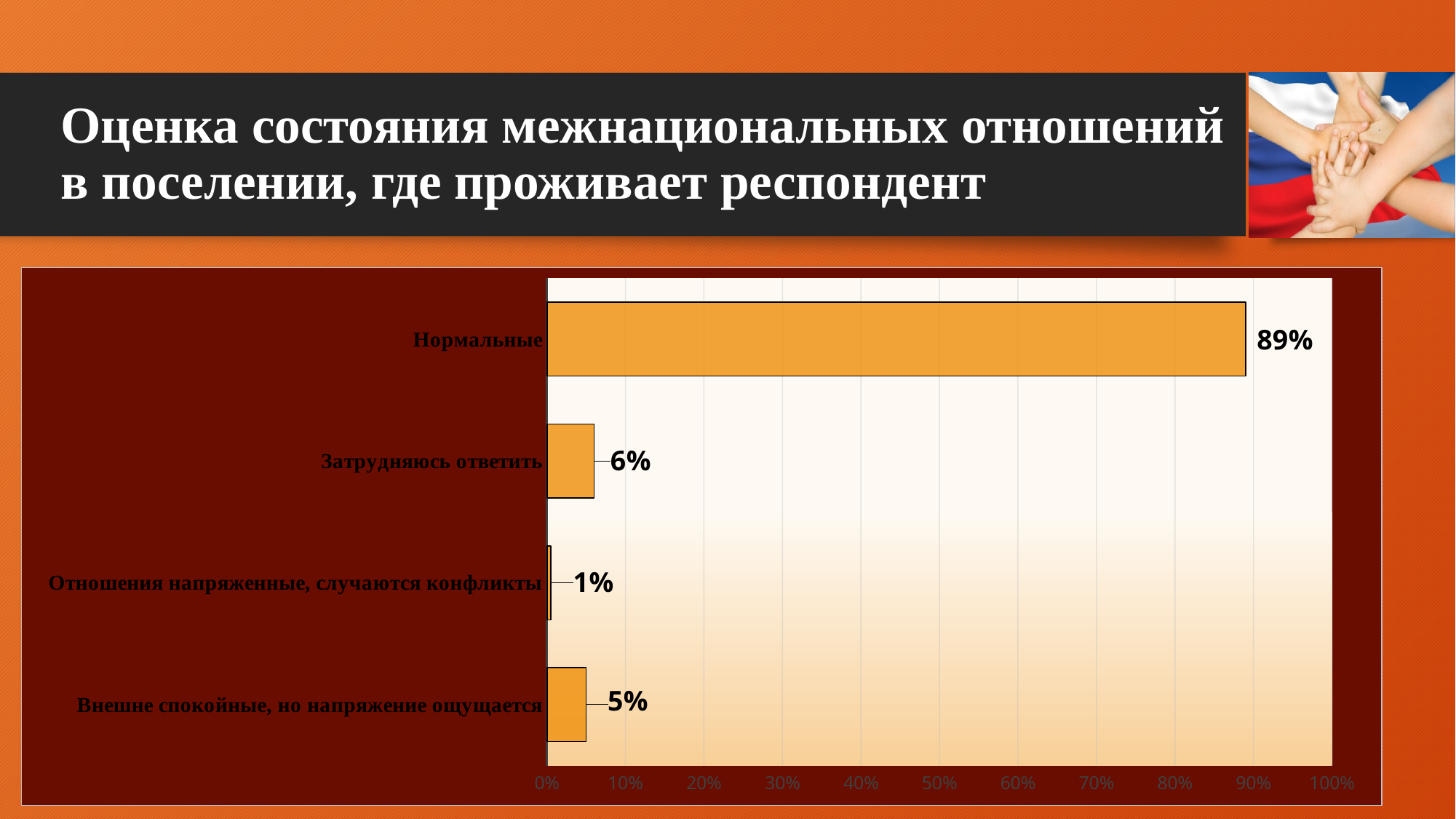
What is the value for Затрудняюсь ответить? 6% What is the value for Отношения напряженные, случаются конфликты? 1% What is the difference between the values for Нормальные and Затрудняюсь ответить? 83% Which is larger: the value for Затрудняюсь ответить or the value for Внешне спокойные, но напряжение ощущается? Затрудняюсь ответить Is the value for Нормальные greater or less than 80%? greater What is the difference between the values for Затрудняюсь ответить and Внешне спокойные, но напряжение ощущается? 1% What is the value for Нормальные? 89% Which category has the highest value? Нормальные Which category has the lowest value? Отношения напряженные, случаются конфликты What kind of chart is shown on the slide? bar chart What is the value for Внешне спокойные, но напряжение ощущается? 5% How many categories are shown in the chart? 4